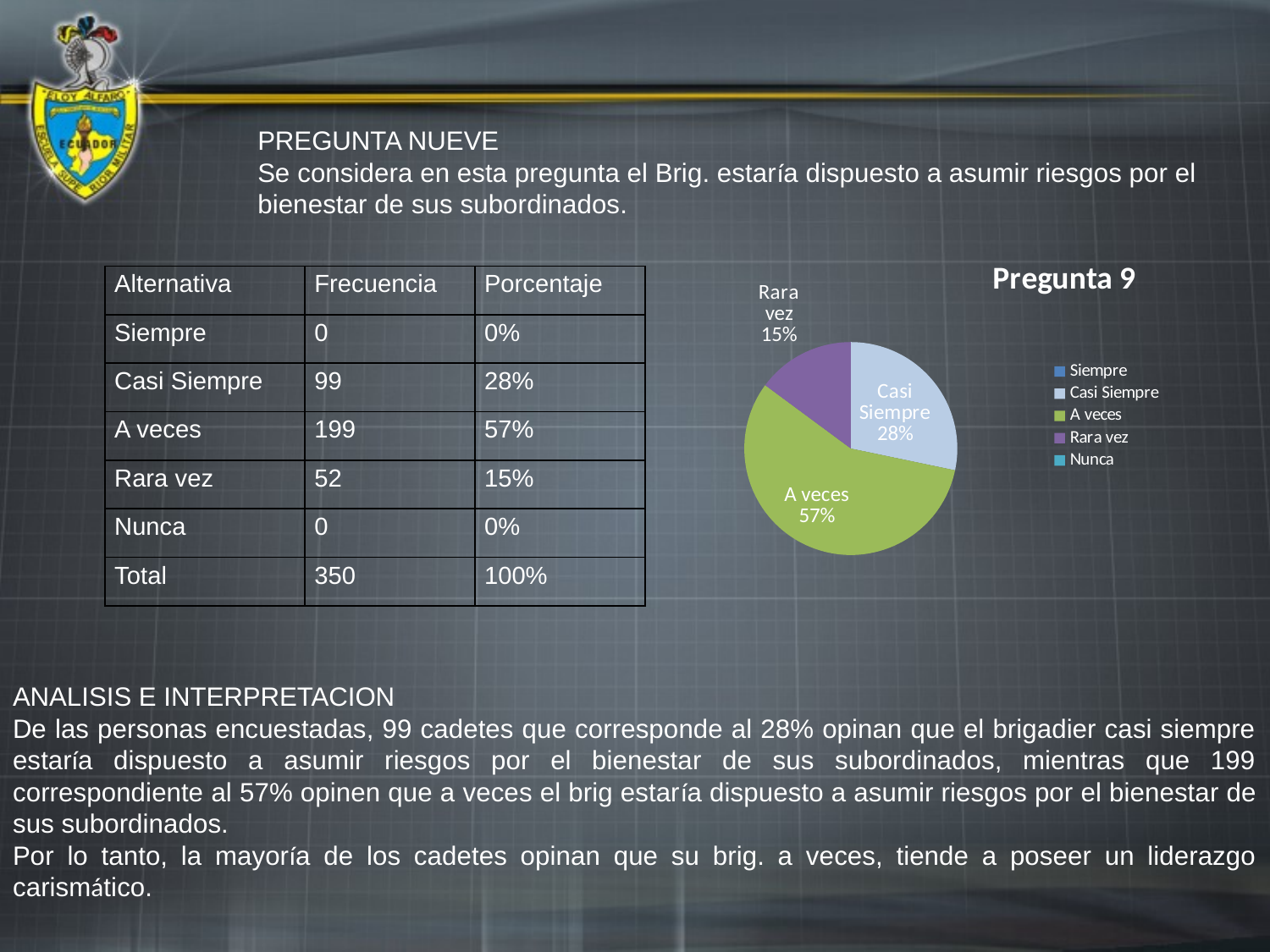
How many entries does the chart's legend list? 5 What share of the pie does the 'Casi Siempre' slice represent? 28% Which legend entry is shown in green in the pie chart? A veces What share of the pie does the 'A veces' slice represent? 57% Which slice is larger, 'Casi Siempre' or 'Rara vez'? Casi Siempre What is the difference between the 'Casi Siempre' share and the 'Rara vez' share? 13% What share of the pie does the 'Rara vez' slice represent? 15% What is the title of the chart? Pregunta 9 How many slices with a visible label are shown in the pie chart? 3 What kind of chart is shown on the slide? pie chart Which category has the largest slice in the pie chart? A veces What is the difference between the 'A veces' share and the 'Casi Siempre' share? 29%